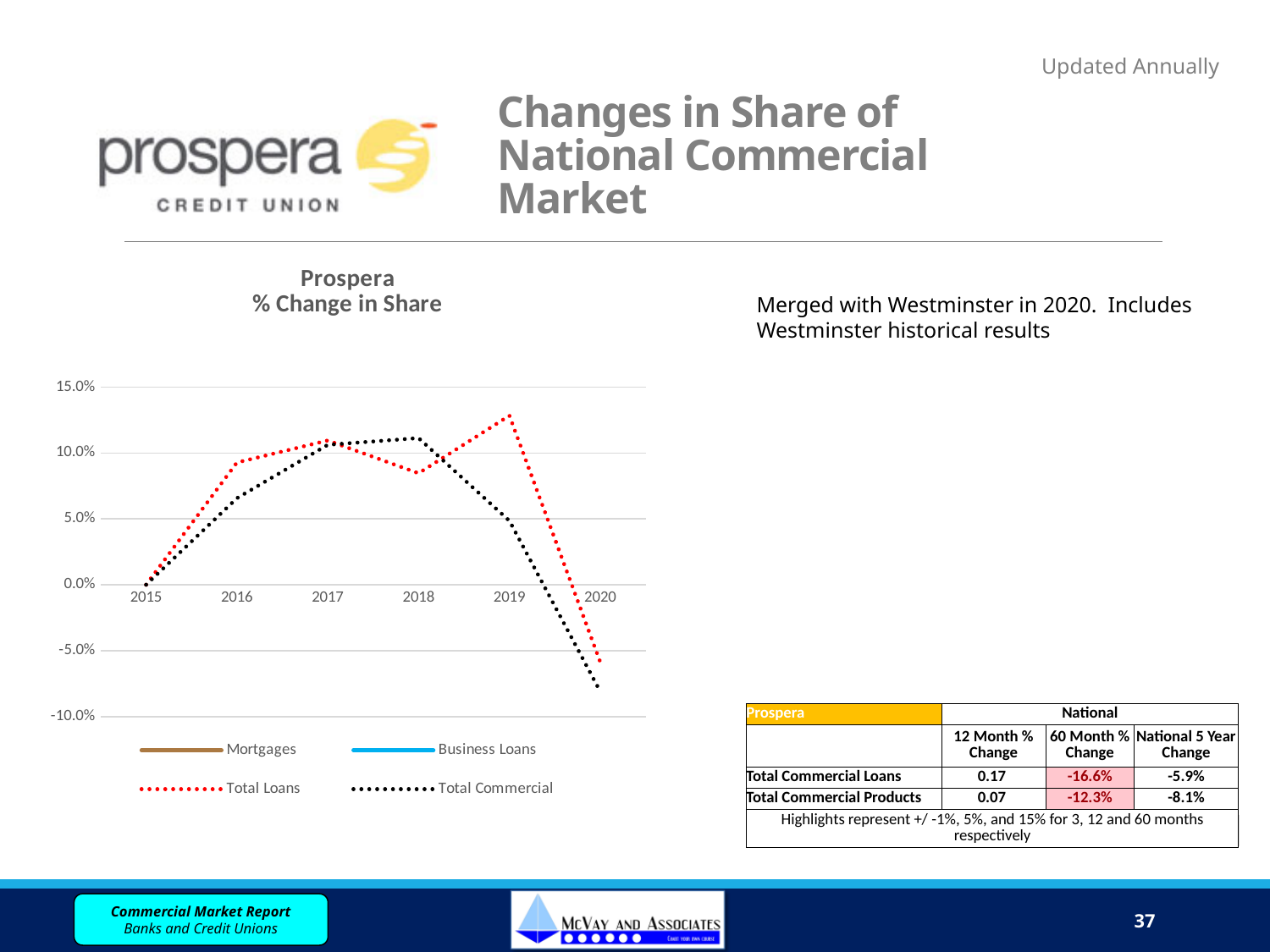
In which year is the Total Loans series at its highest? 2019 Is the Total Commercial value for 2020 greater or less than -5.0%? less What kind of chart is shown on the slide? line chart In 2019, which is larger: Total Loans or Total Commercial? Total Loans How many series does the chart legend list? 4 Is the Total Loans value for 2020 greater or less than 0.0%? less Is the Total Loans value for 2016 greater or less than 5.0%? greater Do the Total Loans and Total Commercial series rise or fall from 2019 to 2020? fall How many years are shown on the x axis of the chart? 6 In which year is the Total Commercial series at its lowest? 2020